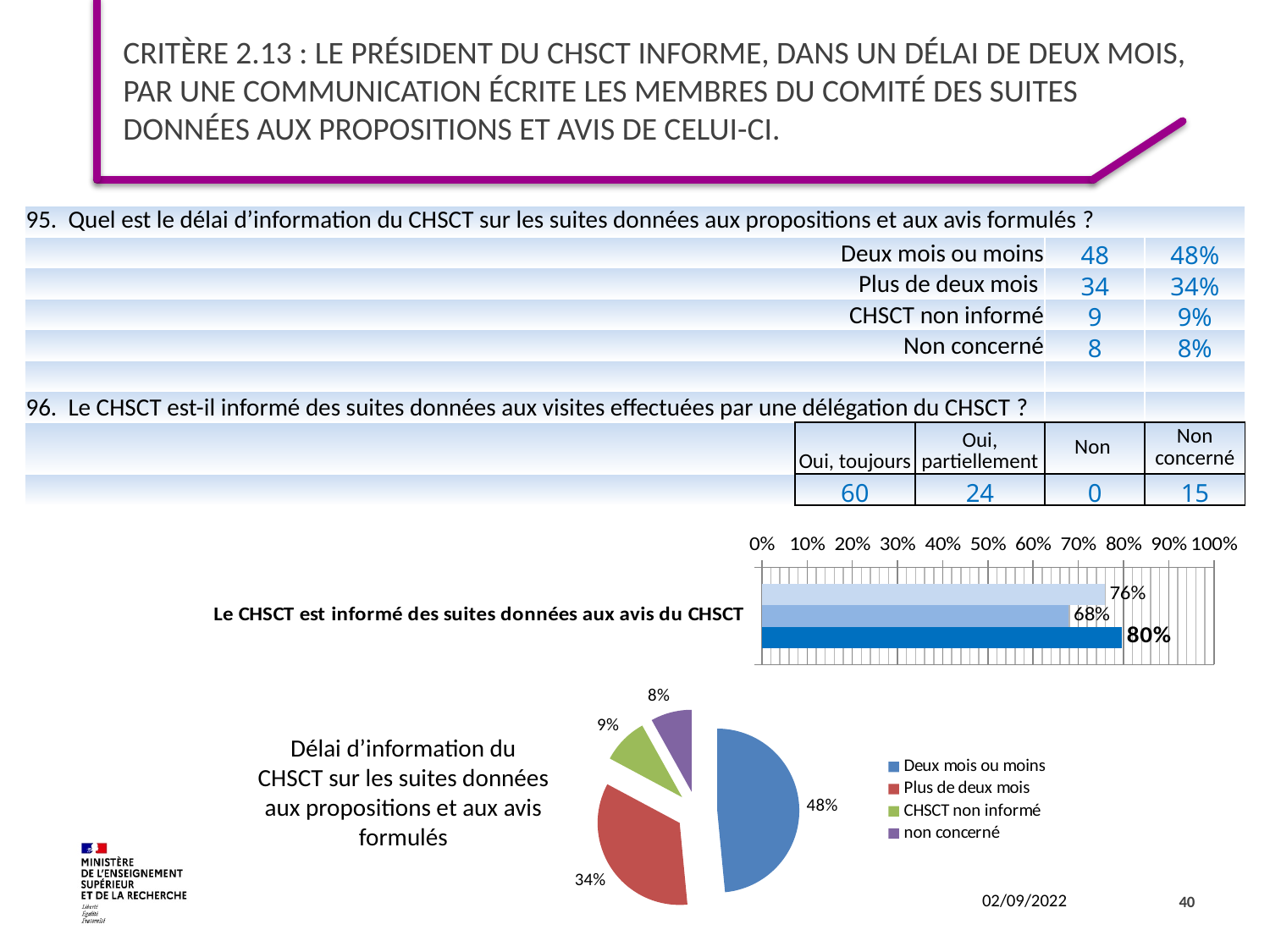
How many entries does the legend of the pie chart titled 'Délai d'information du CHSCT sur les suites données aux propositions et aux avis formulés' list? 4 How many bars are plotted in the bar chart titled 'Le CHSCT est informé des suites données aux avis du CHSCT'? 3 What kind of chart is the chart titled 'Délai d'information du CHSCT sur les suites données aux propositions et aux avis formulés'? Pie chart In the bar chart titled 'Le CHSCT est informé des suites données aux avis du CHSCT', what is the value of the bottom bar? 80% In the pie chart titled 'Délai d'information du CHSCT sur les suites données aux propositions et aux avis formulés', what share is 'Deux mois ou moins'? 48% In the bar chart titled 'Le CHSCT est informé des suites données aux avis du CHSCT', what is the value of the middle bar? 68% In the pie chart titled 'Délai d'information du CHSCT sur les suites données aux propositions et aux avis formulés', which category has the largest slice? Deux mois ou moins In the pie chart titled 'Délai d'information du CHSCT sur les suites données aux propositions et aux avis formulés', which category has the smallest slice? non concerné In the bar chart titled 'Le CHSCT est informé des suites données aux avis du CHSCT', what is the difference in percentage points between the bottom bar and the middle bar? 12 percentage points In the pie chart titled 'Délai d'information du CHSCT sur les suites données aux propositions et aux avis formulés', what share is 'Plus de deux mois'? 34% In the pie chart titled 'Délai d'information du CHSCT sur les suites données aux propositions et aux avis formulés', what share is 'CHSCT non informé'? 9% In the pie chart titled 'Délai d'information du CHSCT sur les suites données aux propositions et aux avis formulés', what is the difference in percentage points between 'Deux mois ou moins' and 'Plus de deux mois'? 14 percentage points